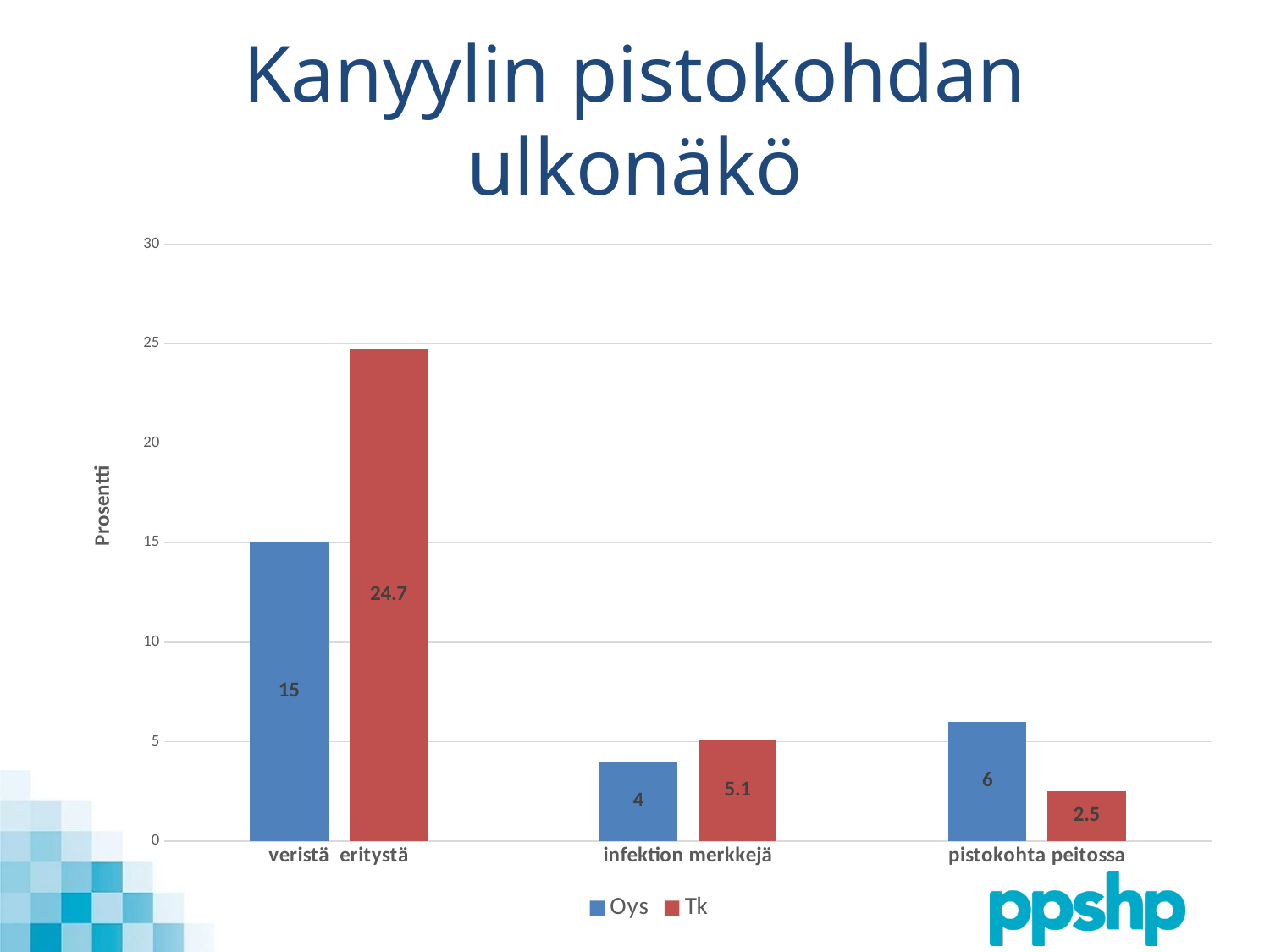
What is the Oys value for infektion merkkejä? 4 What is the Oys value for pistokohta peitossa? 6 Which is larger for pistokohta peitossa, Oys or Tk? Oys What kind of chart is shown on the slide? bar chart Which category has the highest Tk value? veristä eritystä What is the Tk value for pistokohta peitossa? 2.5 What is the Tk value for veristä eritystä? 24.7 How many categories are shown on the x axis? 3 How many series does the legend list? 2 Which category has the lowest Oys value? infektion merkkejä What is the difference between the Tk and Oys values for veristä eritystä? 9.7 Is the Tk value for veristä eritystä greater or less than 20? greater